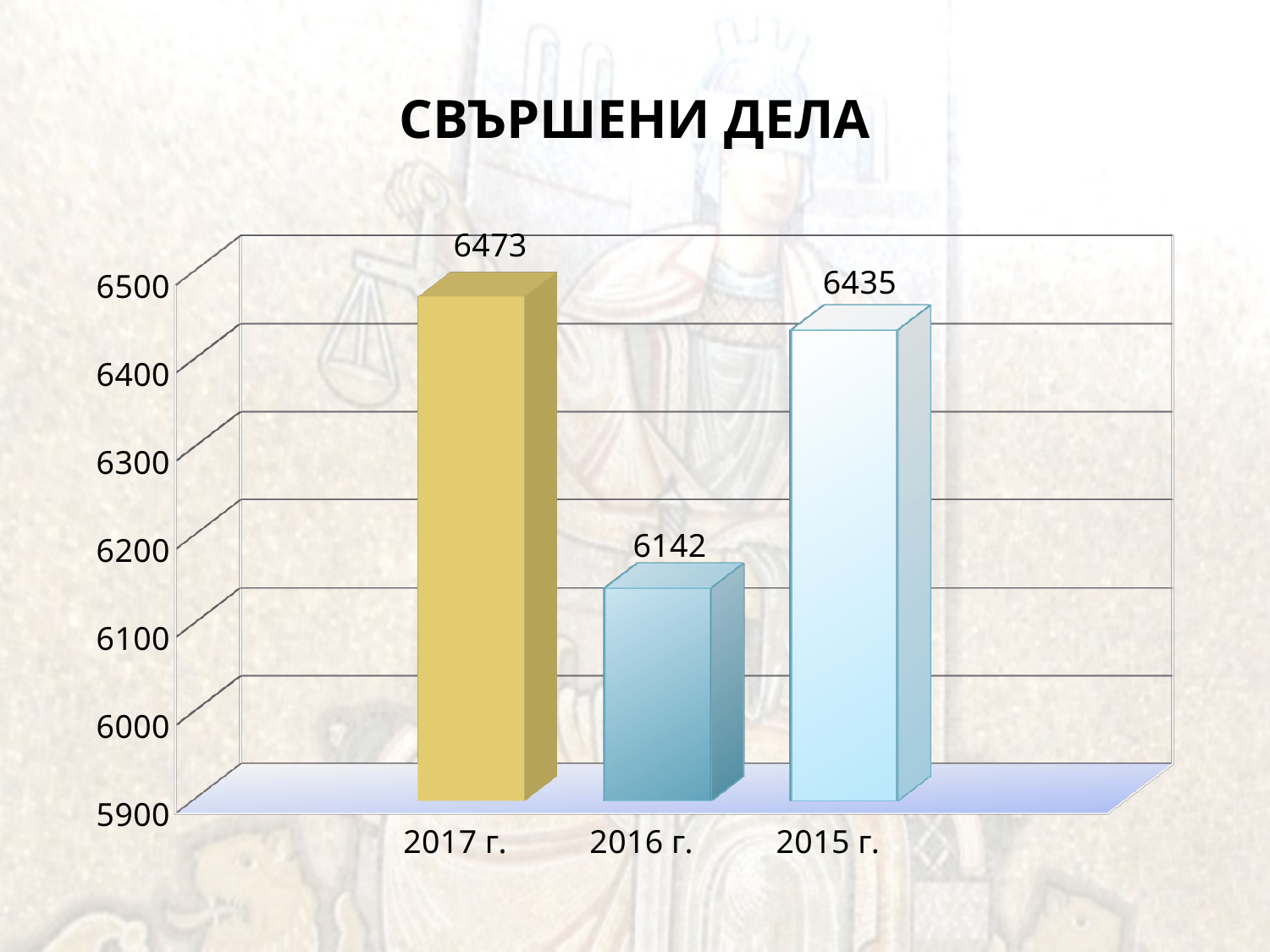
What is the difference between the values for 2015 г. and 2016 г.? 293 What is the value for 2017 г.? 6473 What is the value for 2015 г.? 6435 Which year has the lowest value? 2016 г. Is the value for 2016 г. greater or less than 6200? less Which year has the highest value? 2017 г. Which is larger, the value for 2017 г. or the value for 2015 г.? 2017 г. What is the difference between the values for 2017 г. and 2016 г.? 331 What is the title of the chart? СВЪРШЕНИ ДЕЛА How many categories are shown on the chart? 3 What is the value for 2016 г.? 6142 What kind of chart is shown on the slide? bar chart